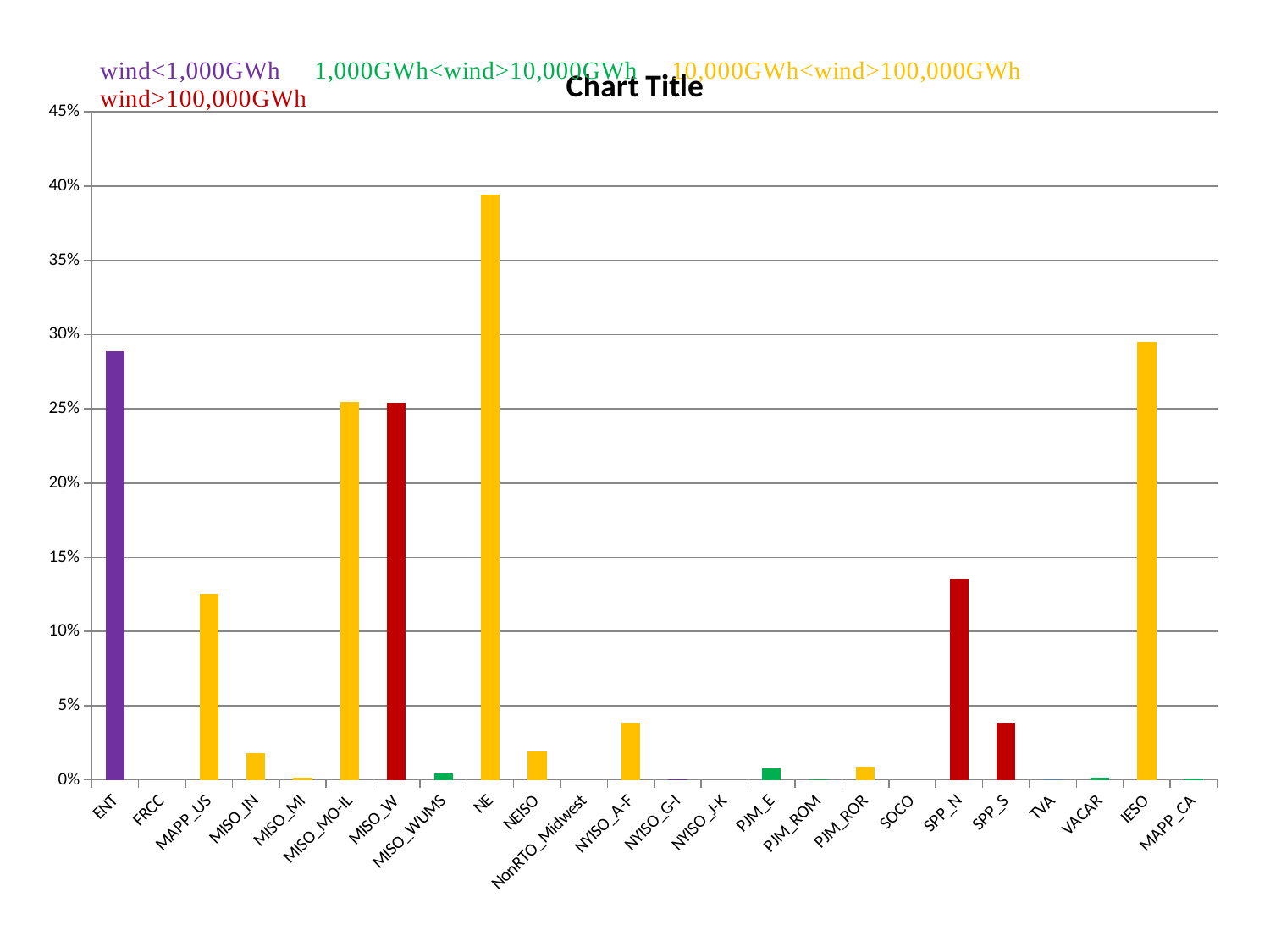
Is the value for MISO_W greater or less than 20%? greater What kind of chart is shown on the slide? bar chart Is the value for MAPP_US greater or less than 10%? greater Which is larger, the value for NE or the value for IESO? NE Which category has the highest bar in the chart? NE Which is larger, the value for SPP_N or the value for SPP_S? SPP_N Is the value for ENT greater or less than 25%? greater What is the title shown on the chart? Chart Title How many categories are shown along the x axis of the chart? 24